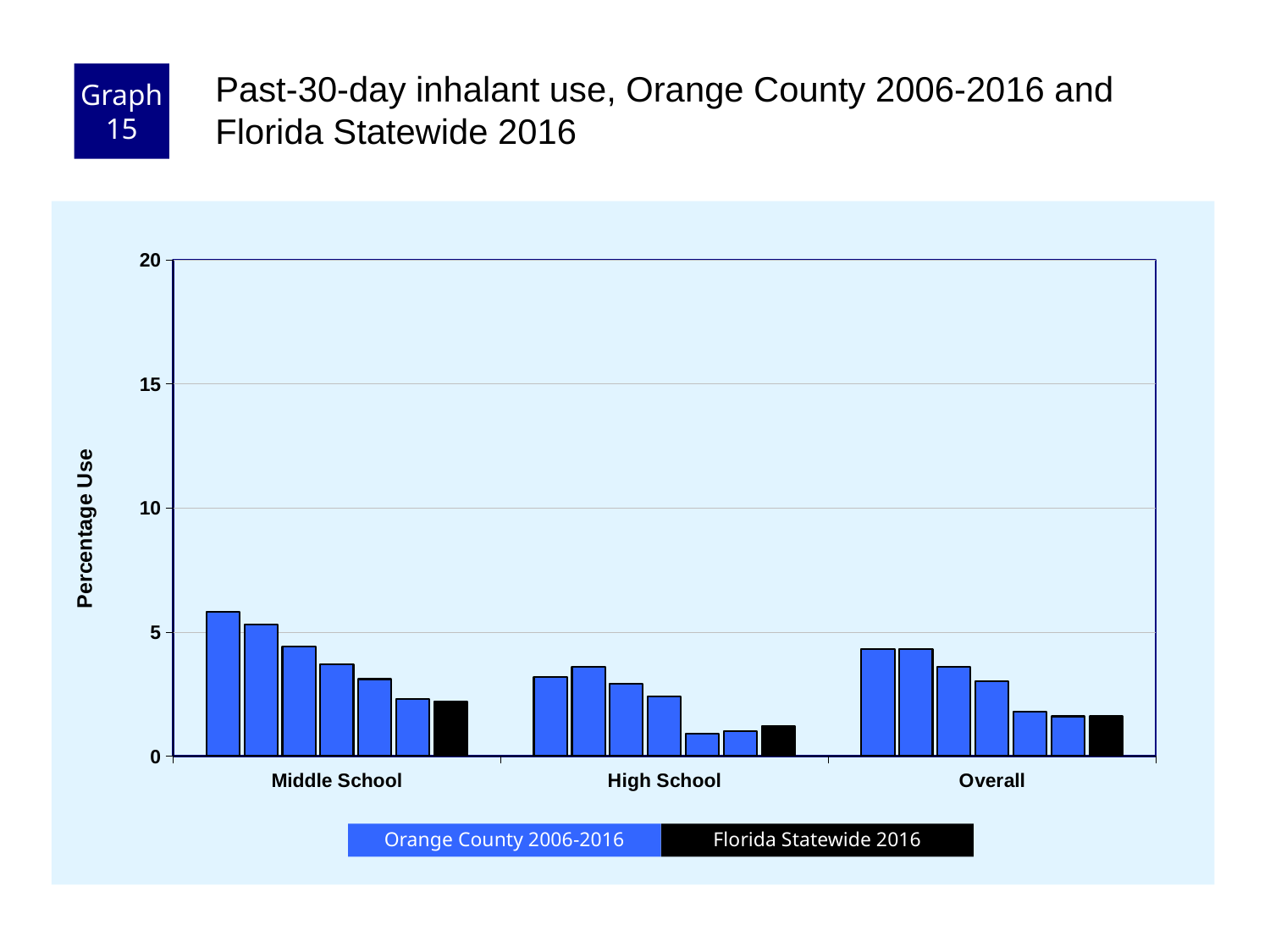
What is the label on the y axis? Percentage Use Is the Florida Statewide 2016 value for High School greater or less than 5? less Which is larger: the first Orange County bar for Overall or the first Orange County bar for High School? Overall How many series does the legend list? 2 Is the value of the tallest Middle School bar greater or less than 5? greater Are any bars on the chart greater than 10? No Which is larger: the first Orange County bar for Middle School or the first Orange County bar for High School? Middle School What kind of chart is shown on the slide? Bar chart What colour represents Florida Statewide 2016 in the legend? Black How many school-level categories are shown on the x axis? 3 Do the Orange County bars for Middle School generally rise or fall from 2006 to 2016? fall Which category has the tallest bar overall? Middle School